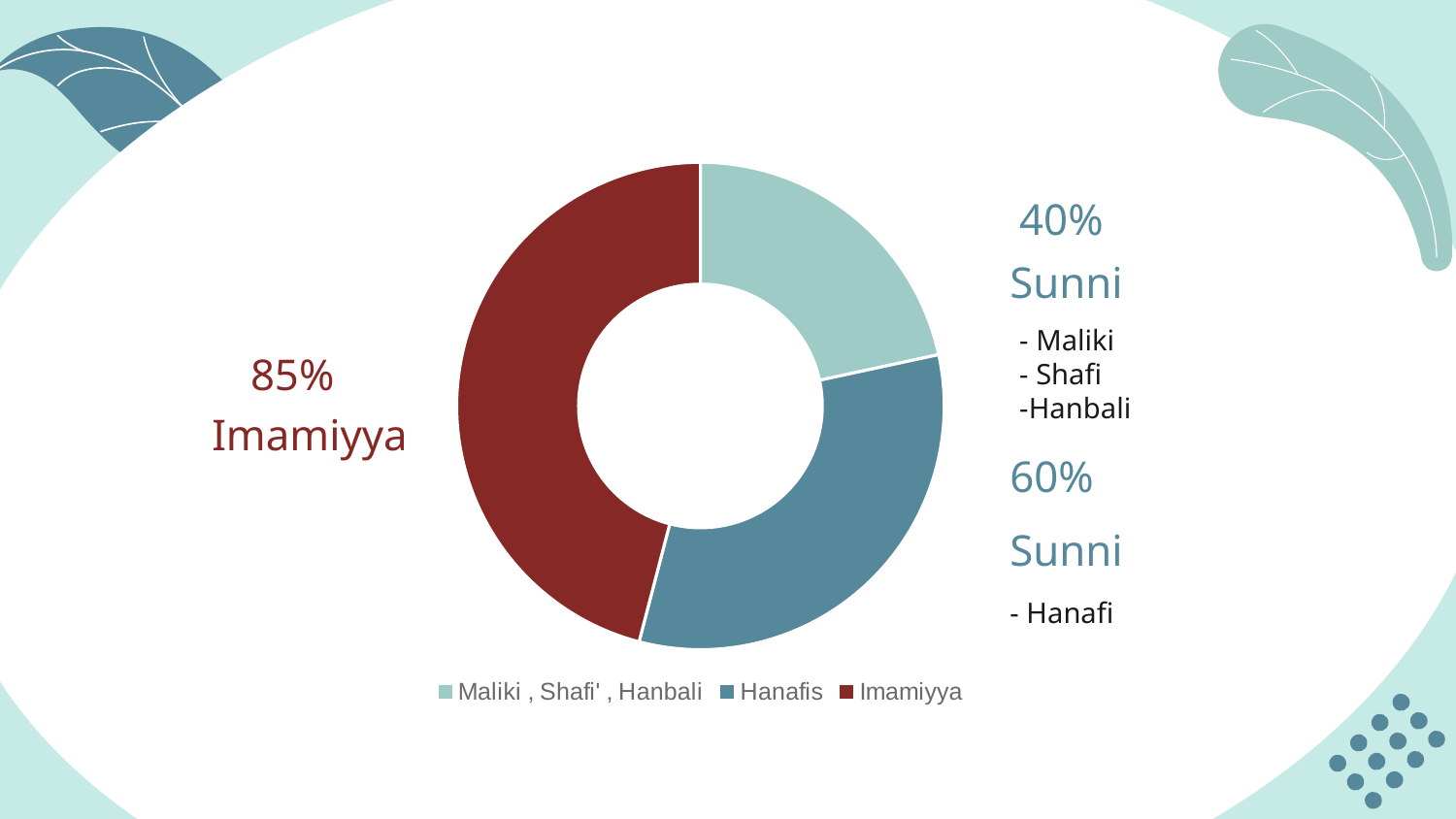
Which slice is larger, Hanafis or Maliki , Shafi' , Hanbali? Hanafis How many slices does the donut chart have? 3 Which slice is larger, Imamiyya or Hanafis? Imamiyya Which slice of the donut chart is the smallest? Maliki , Shafi' , Hanbali Which slice of the donut chart is the largest? Imamiyya What colour is the Imamiyya slice in the donut chart? Dark red What kind of chart is shown on the slide? Donut (pie) chart Which legend entry is shown in light teal? Maliki , Shafi' , Hanbali How many entries does the chart legend list? 3